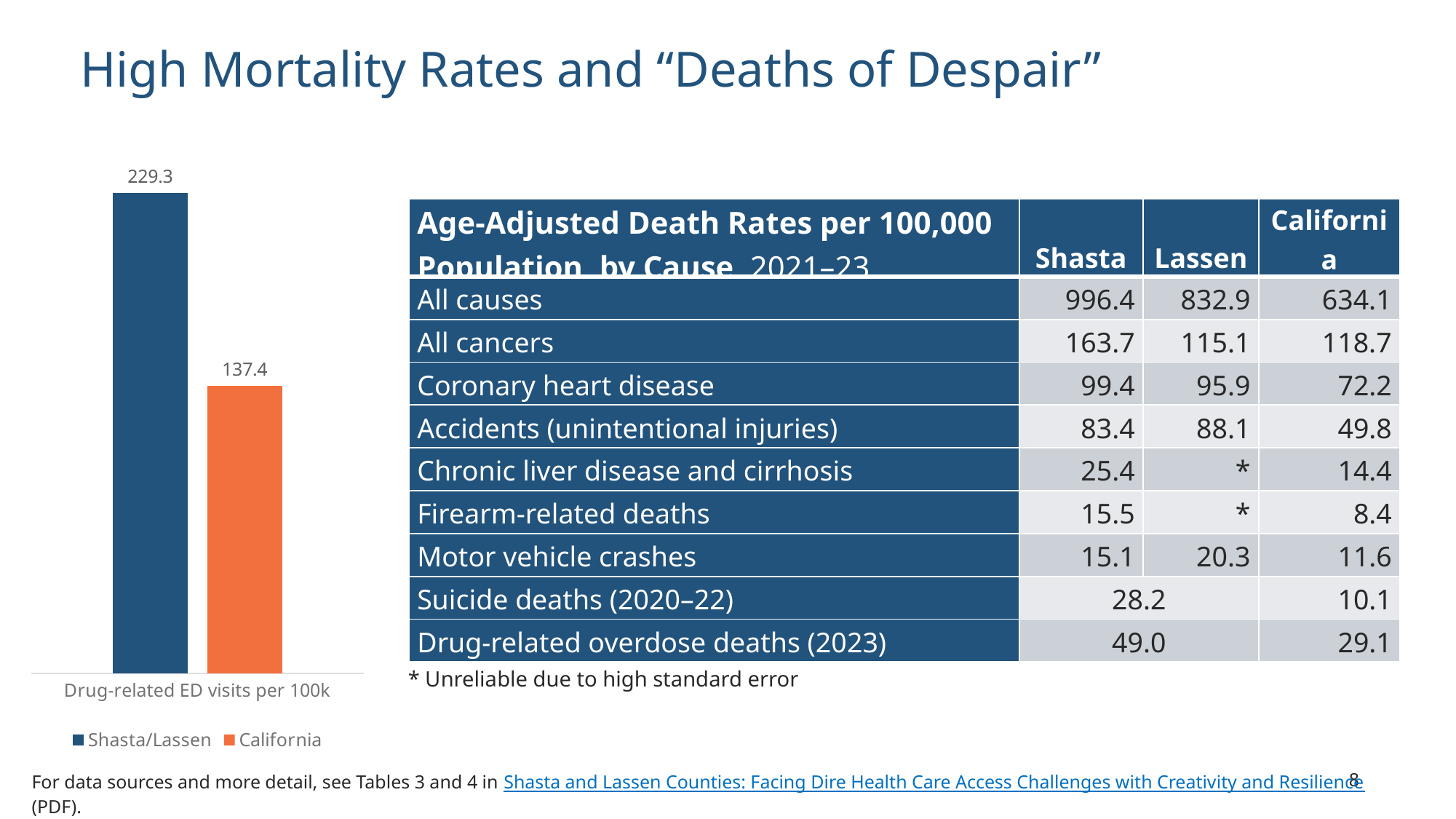
What is the value for Shasta/Lassen in the bar chart of drug-related ED visits per 100k? 229.3 What is the category label shown under the bars in the chart? Drug-related ED visits per 100k Which series has the higher value in the bar chart of drug-related ED visits per 100k? Shasta/Lassen Which series is shown in orange in the bar chart? California In the bar chart, is the value for Shasta/Lassen larger or smaller than the value for California? larger What kind of chart is shown on the left of the slide? bar chart What is the value for California in the bar chart of drug-related ED visits per 100k? 137.4 How many series does the legend of the bar chart list? 2 What is the difference between the Shasta/Lassen and California values in the bar chart of drug-related ED visits per 100k? 91.9 How many bars are plotted in the bar chart on the slide? 2 Which series has the lower value in the bar chart of drug-related ED visits per 100k? California